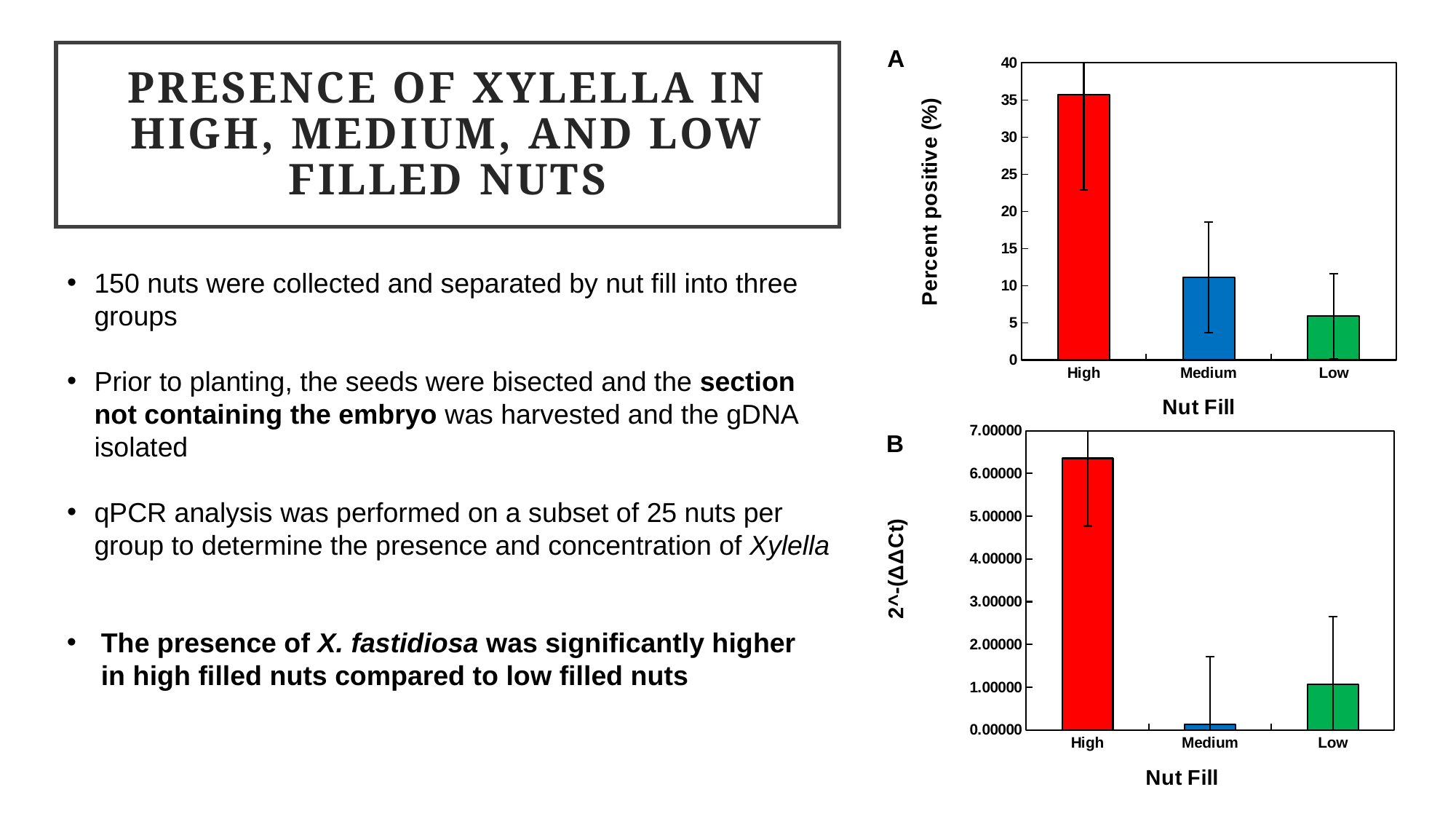
In chart B (2^-(ΔΔCt)), is the value for High greater or less than 6.00000? greater In chart B (2^-(ΔΔCt)), which nut fill category has the lowest value? Medium In chart A (Percent positive), which nut fill category has the lowest percent positive? Low In chart A (Percent positive), which nut fill category has the highest percent positive? High In chart B (2^-(ΔΔCt)), which nut fill category has the highest value? High In chart A (Percent positive), how many nut fill categories are plotted? 3 In chart A (Percent positive), which is larger, the value for Medium or the value for Low? Medium In chart A, what is the title of the x axis? Nut Fill In chart A (Percent positive), is the value for Medium greater or less than 15? less In chart B (2^-(ΔΔCt)), which is larger, the value for Low or the value for Medium? Low In chart A (Percent positive), is the value for High greater or less than 30? greater In chart A (Percent positive), what kind of chart is shown? bar chart